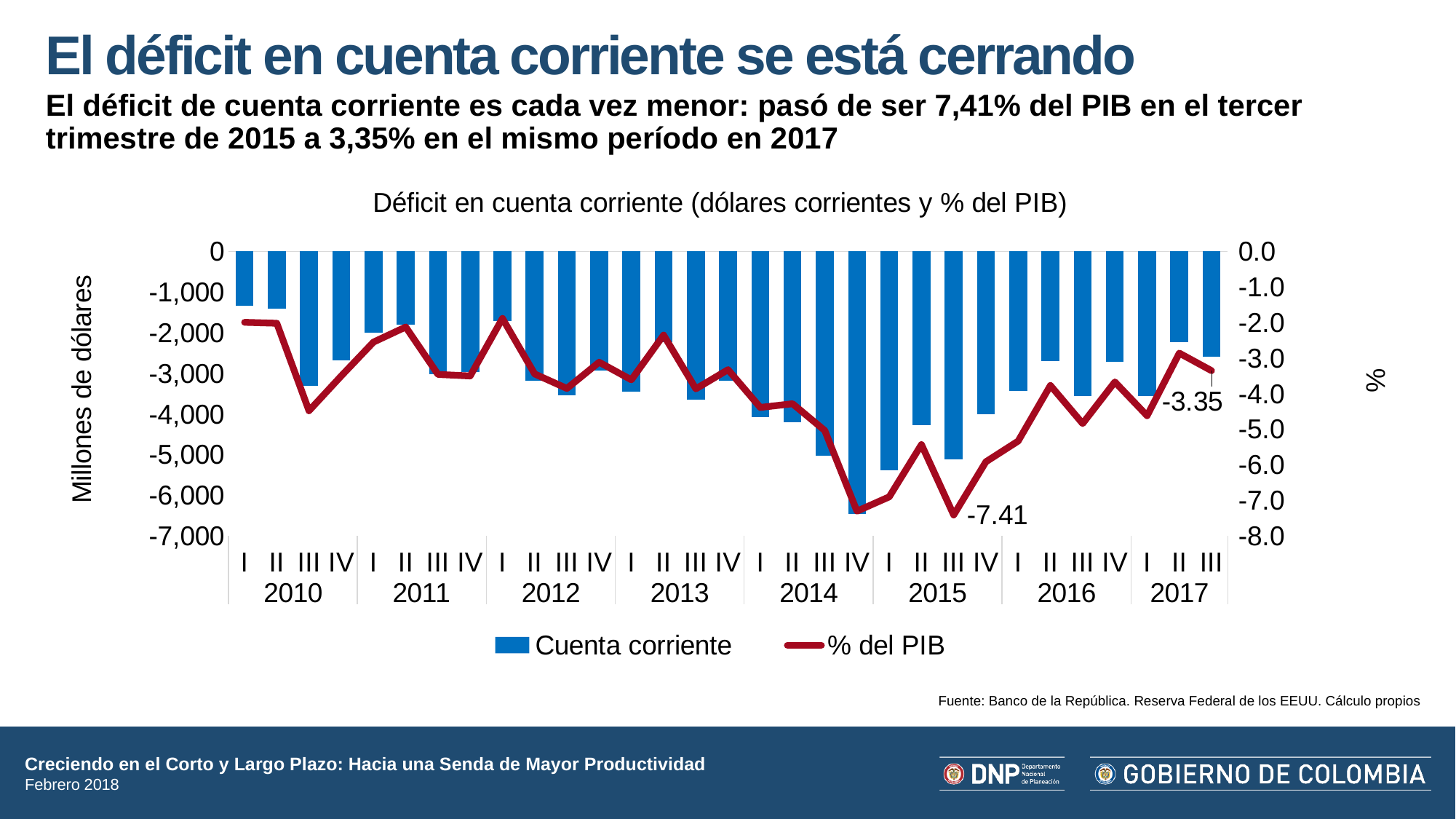
How many quarterly data points are plotted on the x axis? 31 In which quarter does the % del PIB line reach its lowest (most negative) point? 2015 III What is the % del PIB value labelled for the third quarter of 2015? -7.41 In which quarter is the Cuenta corriente bar the lowest (most negative)? 2014 IV What is the label of the left vertical axis? Millones de dólares How many series does the legend list? 2 From the third quarter of 2015 to the third quarter of 2017, does the % del PIB line generally rise or fall? rise Is the Cuenta corriente value for 2010 I greater or less than -2,000? greater By how many percentage points did the % del PIB value change between the third quarter of 2015 (-7.41) and the third quarter of 2017 (-3.35)? 4.06 What kind of chart is shown on the slide? A combined bar and line chart Is the Cuenta corriente value for 2014 IV greater or less than -6,000? less What is the % del PIB value labelled for the third quarter of 2017? -3.35